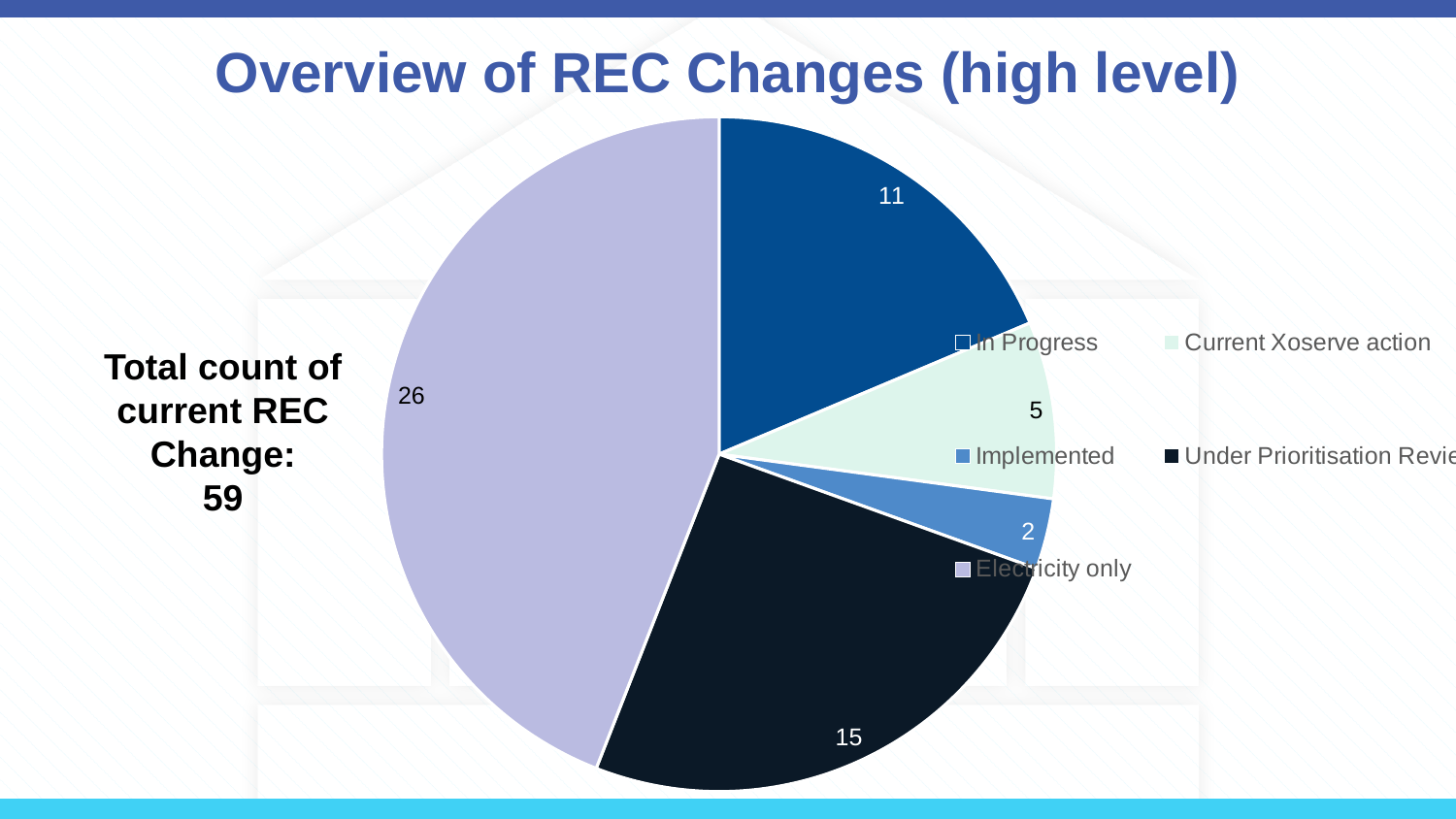
Which category has the smallest slice of the pie? Implemented What type of chart is shown on the slide? pie chart What is the value of the Implemented slice? 2 What is the value of the Current Xoserve action slice? 5 What is the value of the In Progress slice? 11 What is the total count of current REC Changes stated on the slide? 59 What is the difference between the Electricity only value and the In Progress value? 15 What is the value of the Electricity only slice? 26 Which is larger, the In Progress slice or the Current Xoserve action slice? In Progress How many slices does the pie chart have? 5 Which category has the largest slice of the pie? Electricity only What is the title of the slide containing the pie chart? Overview of REC Changes (high level)